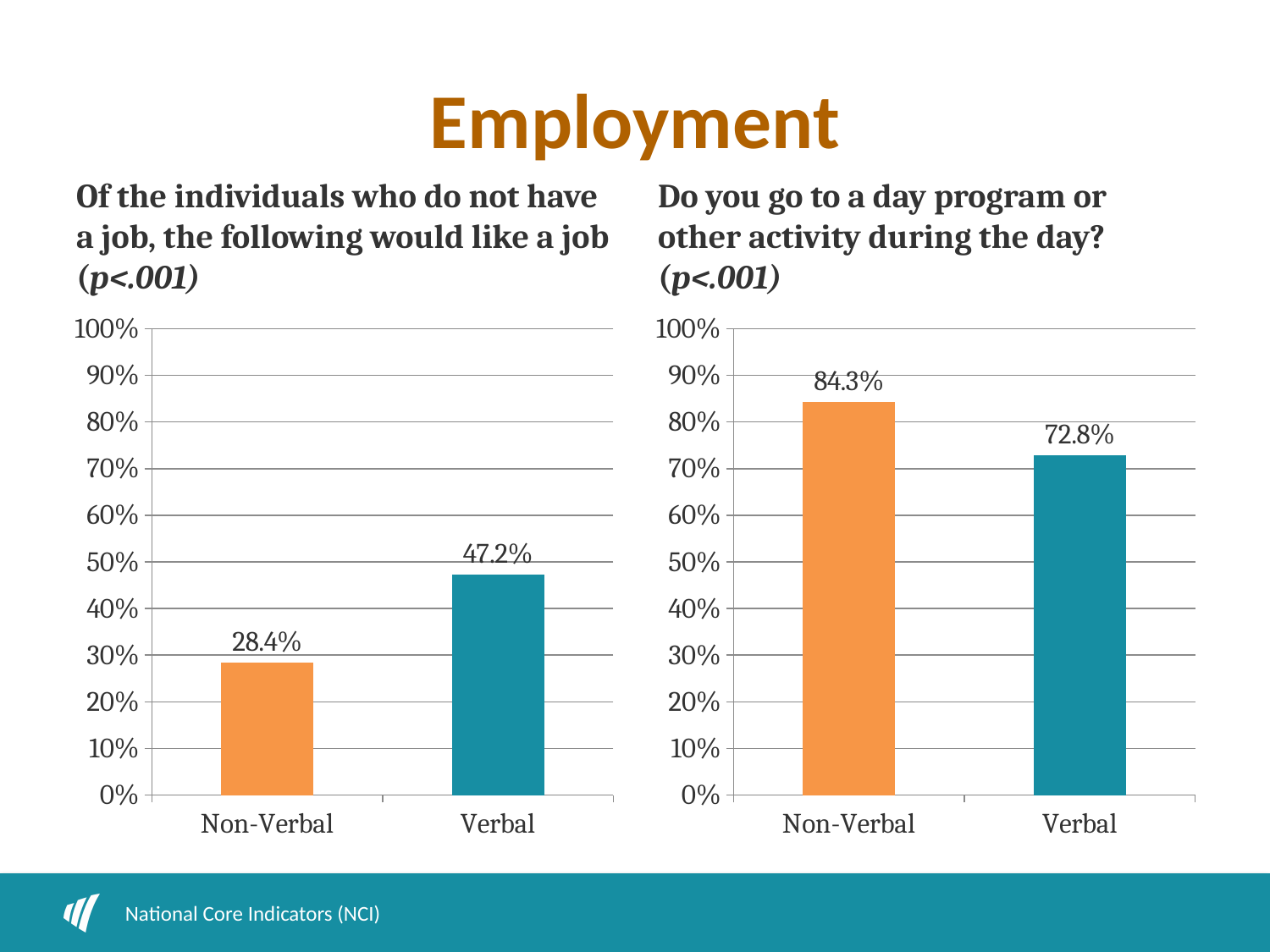
In the right chart (day program or other activity), what is the value for Non-Verbal? 84.3% In the right chart (day program or other activity), what is the value for Verbal? 72.8% In the left chart (would like a job), what is the difference between the Verbal and Non-Verbal values? 18.8% In the right chart (day program or other activity), which category has the lower value? Verbal How many categories are shown on the x axis of the left chart (would like a job)? 2 In the left chart (would like a job), what is the value for Non-Verbal? 28.4% In the left chart (would like a job), what is the value for Verbal? 47.2% What is the title of the slide? Employment In the right chart (day program or other activity), what is the difference between the Non-Verbal and Verbal values? 11.5% In the left chart (would like a job), which category has the higher value? Verbal In the right chart (day program or other activity), is the value for Non-Verbal greater or less than 80%? greater What kind of chart is the right chart (day program or other activity)? Bar chart